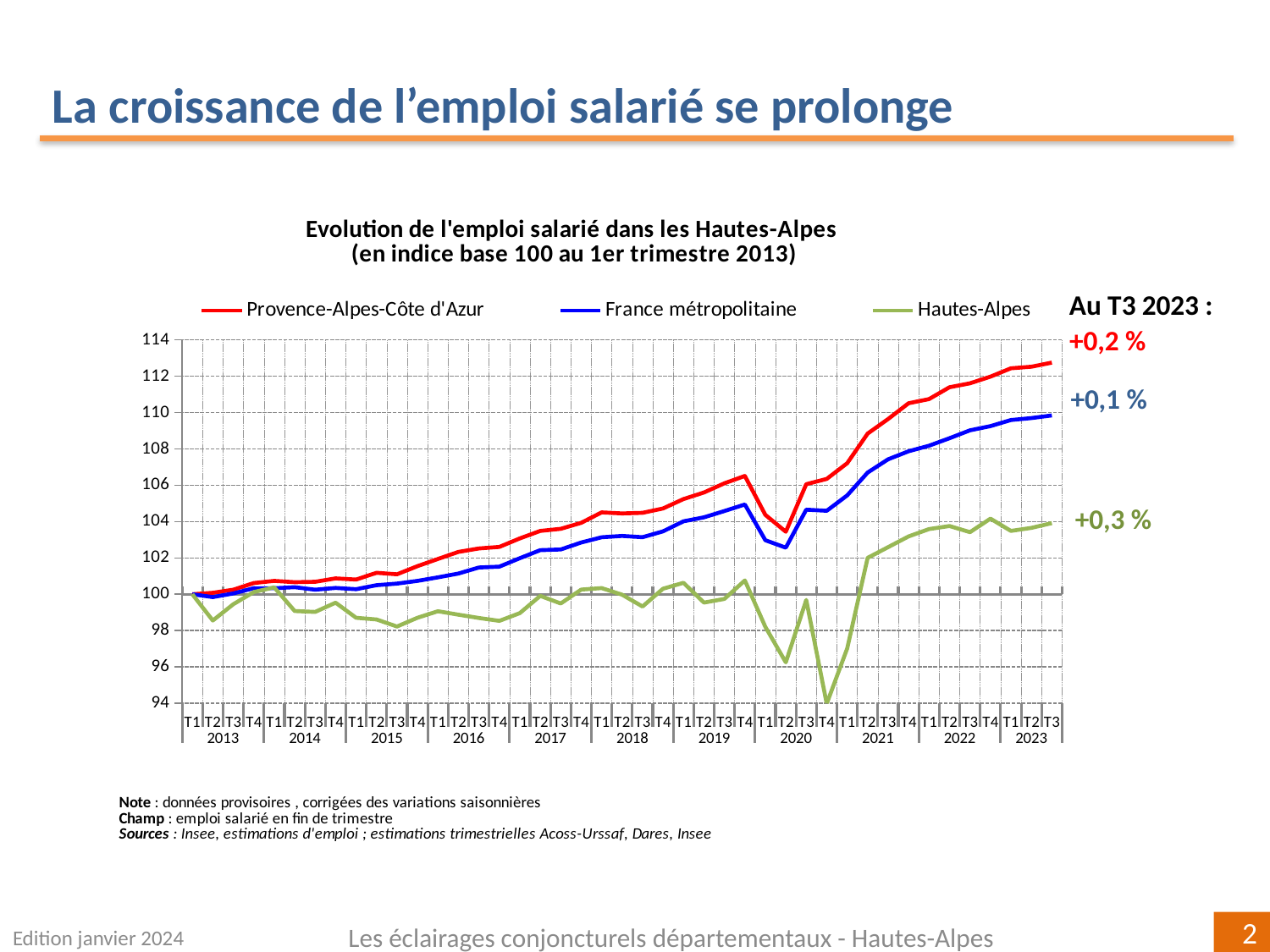
What kind of chart is shown on the slide? line chart What quarterly change is annotated for France métropolitaine at T3 2023? +0,1 % What quarterly change is annotated for Provence-Alpes-Côte d'Azur at T3 2023? +0,2 % Is the value for Hautes-Alpes at T4 2020 greater or less than 96? less What is the title of the chart? Evolution de l'emploi salarié dans les Hautes-Alpes (en indice base 100 au 1er trimestre 2013) Which series are listed in the chart legend? Provence-Alpes-Côte d'Azur, France métropolitaine, Hautes-Alpes Is the value for Provence-Alpes-Côte d'Azur at T3 2023 greater or less than 112? greater Does the Provence-Alpes-Côte d'Azur series rise or fall overall from T1 2013 to T3 2023? rise Which series has the highest index value at T3 2023? Provence-Alpes-Côte d'Azur Which series has the lowest index value at T3 2023? Hautes-Alpes What quarterly change is annotated for Hautes-Alpes at T3 2023? +0,3 % How many series does the chart legend list? 3